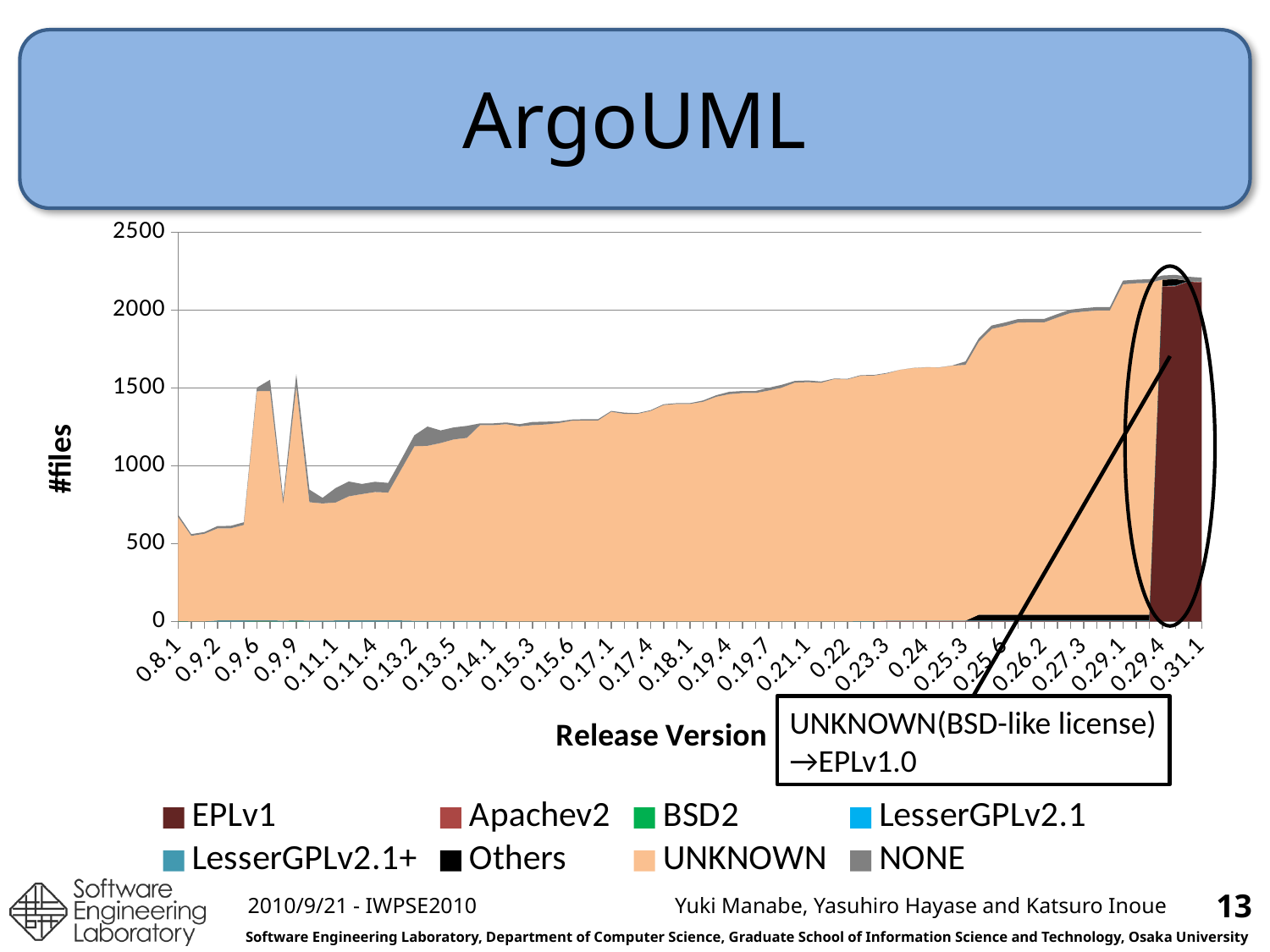
What kind of chart is shown on the slide? Stacked area chart Is the total number of files at release 0.8.1 greater or less than 1000? less What is the title of the slide containing the chart? ArgoUML Which is larger, the total number of files at release 0.31.1 or at release 0.8.1? 0.31.1 Is the total number of files at release 0.22 greater or less than 1500? greater How many series does the legend list? 8 Is the total number of files at release 0.26.2 greater or less than 2000? less Overall, do the total number of files rise or fall from release 0.8.1 to release 0.31.1? Rise Which is larger, the total number of files at release 0.9.6 or at release 0.11.1? 0.9.6 Which series accounts for the largest share of files in most releases before 0.29.4? UNKNOWN What is the label on the y axis of the chart? #files